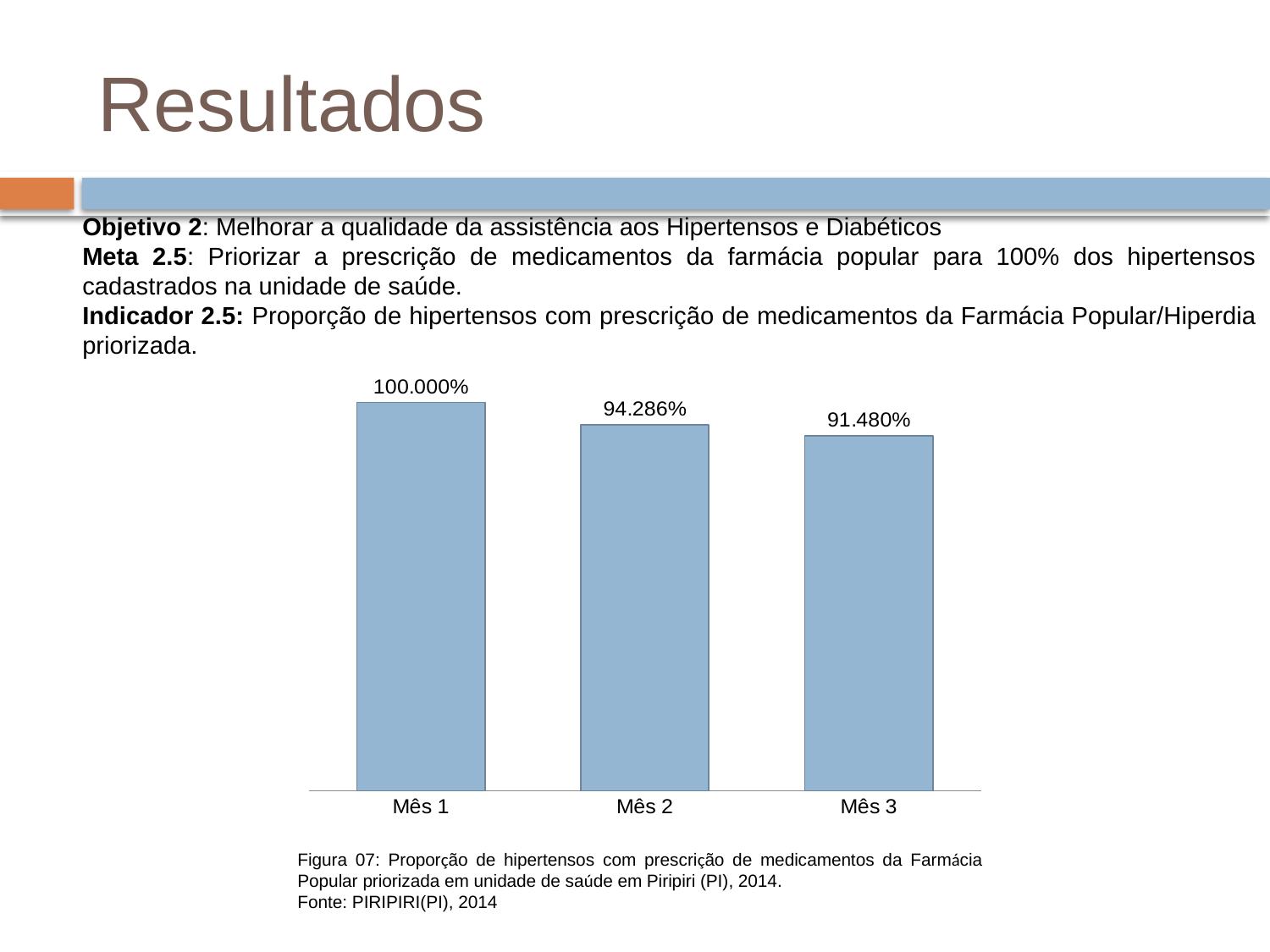
Which month has the lowest value? Mês 3 What is the figure number given in the caption below the chart? Figura 07 What is the value for Mês 1? 100.000% What is the value for Mês 2? 94.286% Which is larger, the value for Mês 2 or the value for Mês 3? Mês 2 How many months are shown on the chart? 3 What is the difference between the values for Mês 1 and Mês 3? 8.520% Which month has the highest value? Mês 1 Do the values rise or fall from Mês 1 to Mês 3? Fall What is the difference between the values for Mês 2 and Mês 3? 2.806% What is the value for Mês 3? 91.480% What kind of chart is shown on the slide? Bar chart